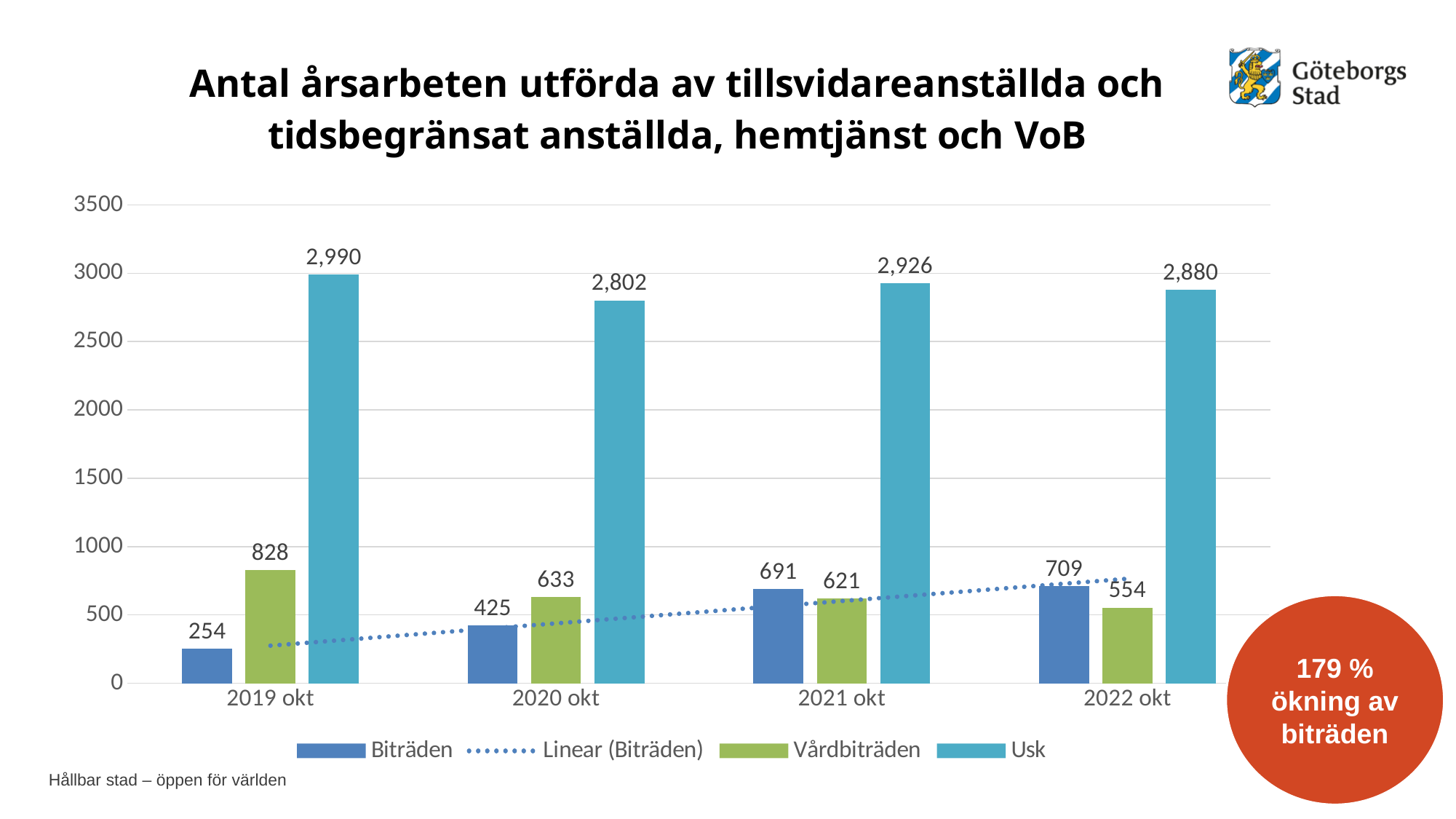
What is the value for Vårdbiträden in 2020 okt? 633 What is the value for Biträden in 2022 okt? 709 How many categories are shown on the x axis? 4 How many entries does the legend list? 4 Which is larger in 2021 okt, Biträden or Vårdbiträden? Biträden In which year is the Usk value lowest? 2020 okt What kind of chart is shown? bar chart In which year is the Biträden value highest? 2022 okt Is the value for Vårdbiträden in 2019 okt greater or less than 1000? less What is the value for Usk in 2019 okt? 2,990 Do the Vårdbiträden values rise or fall from 2019 okt to 2022 okt? fall What is the difference between the Biträden values in 2022 okt and 2019 okt? 455